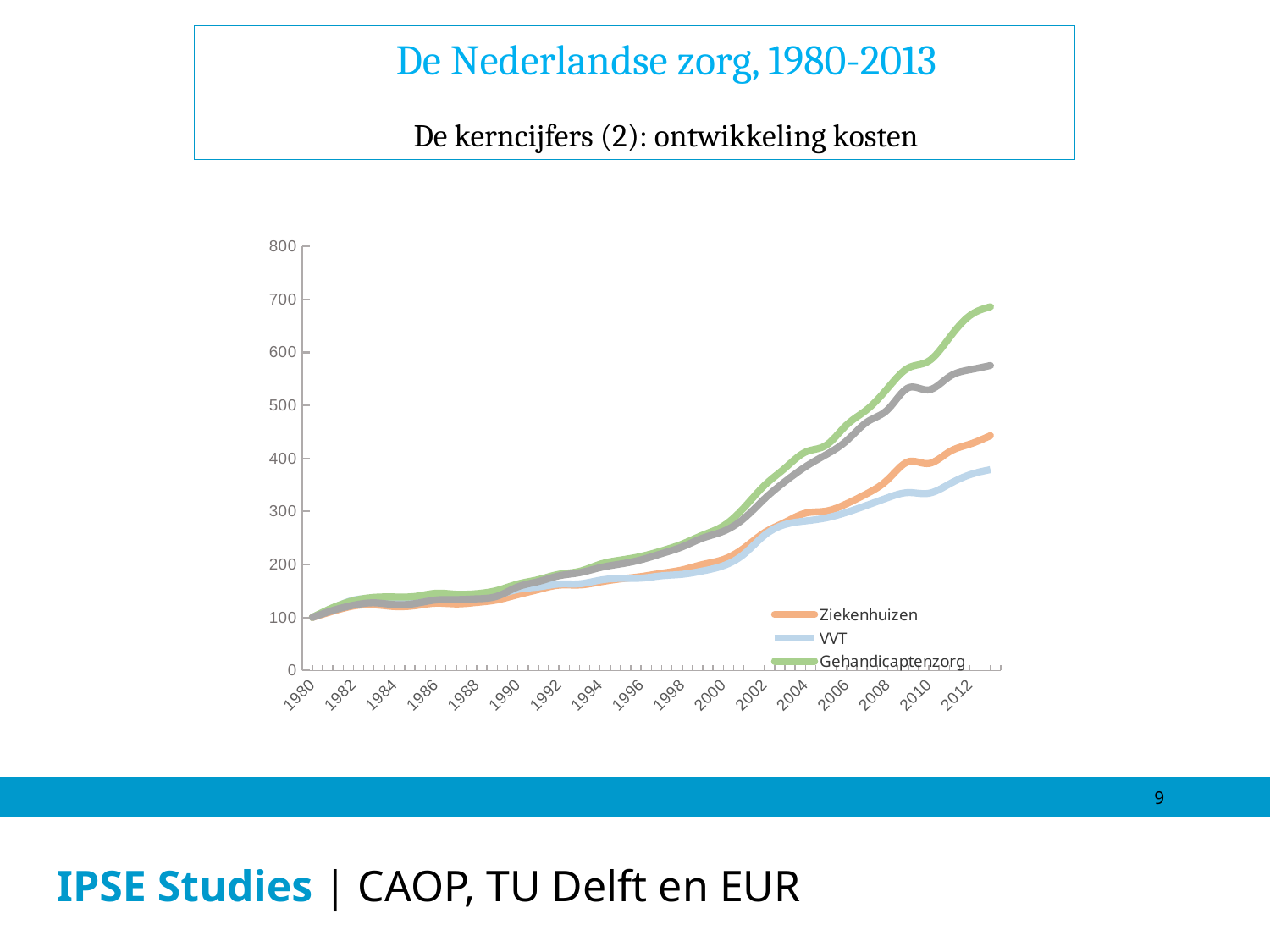
Is the value for VVT in 2012 greater or less than 300? greater At what value do the series start in 1980? 100 Which series has the highest value in 2012? Gehandicaptenzorg What kind of chart is shown on the slide? line chart Is the value for Gehandicaptenzorg in 2012 greater or less than 600? greater What colour is the Ziekenhuizen line in the chart? orange Is the value for Ziekenhuizen in 2012 greater or less than 400? greater How many series does the chart's legend list? 3 Which is larger in 2008, the value for Gehandicaptenzorg or the value for Ziekenhuizen? Gehandicaptenzorg Which series has the lowest value in 2012? VVT Do the values of the series rise or fall from 1980 to 2012? rise